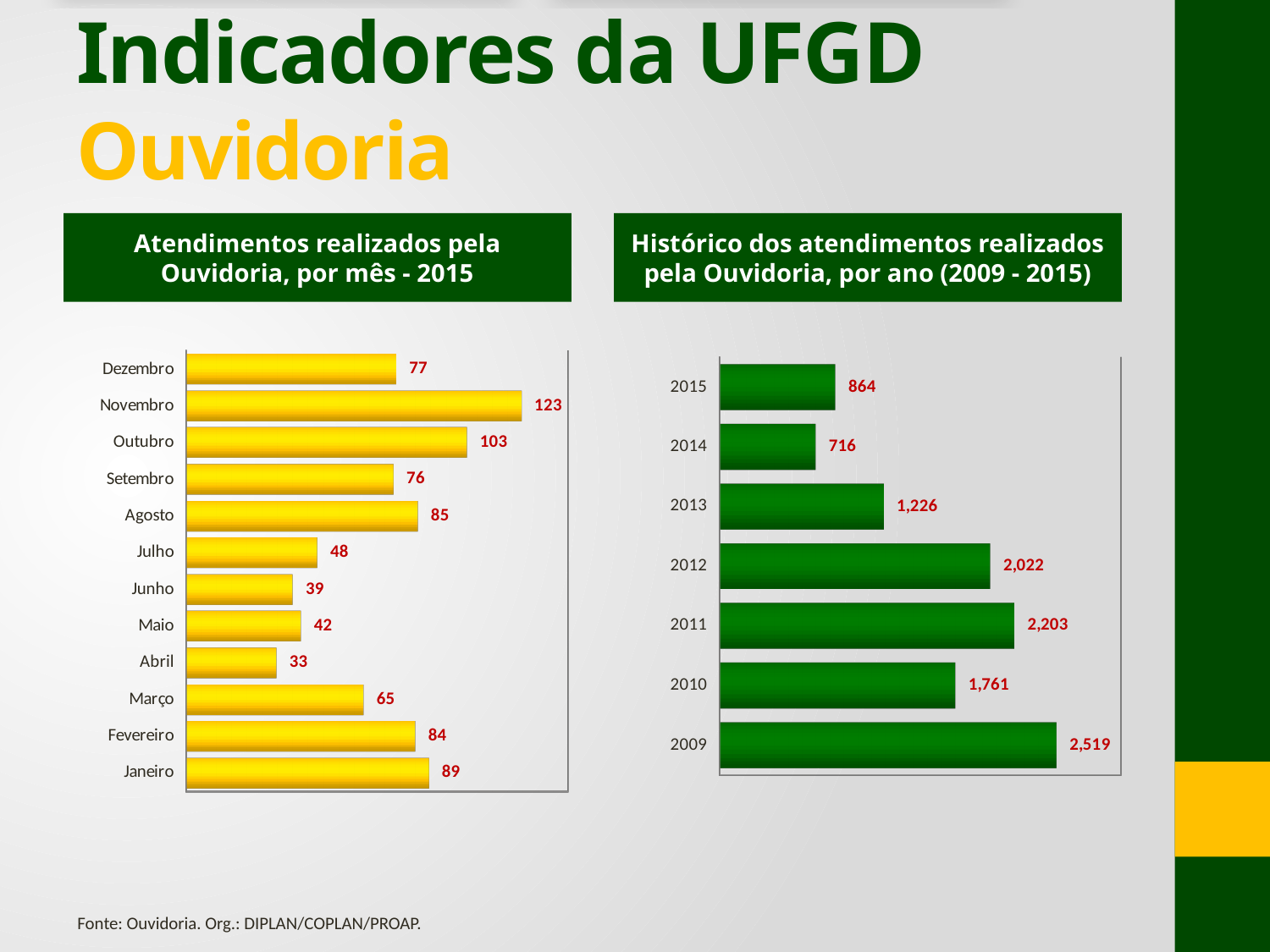
In the left chart (Atendimentos realizados pela Ouvidoria, por mês - 2015), which month has the highest value? Novembro In the left chart (Atendimentos realizados pela Ouvidoria, por mês - 2015), which is larger, Fevereiro or Março? Fevereiro In the right chart (Histórico dos atendimentos realizados pela Ouvidoria, por ano), which year has the lowest value? 2014 What kind of chart is the right chart (Histórico dos atendimentos realizados pela Ouvidoria, por ano)? Bar chart In the left chart (Atendimentos realizados pela Ouvidoria, por mês - 2015), which month has the lowest value? Abril In the left chart (Atendimentos realizados pela Ouvidoria, por mês - 2015), what is the value for Novembro? 123 In the left chart (Atendimentos realizados pela Ouvidoria, por mês - 2015), how many months are shown? 12 In the left chart (Atendimentos realizados pela Ouvidoria, por mês - 2015), what is the difference between Outubro and Setembro? 27 In the right chart (Histórico dos atendimentos realizados pela Ouvidoria, por ano), how many years are shown? 7 In the right chart (Histórico dos atendimentos realizados pela Ouvidoria, por ano), which year has the highest value? 2009 In the right chart (Histórico dos atendimentos realizados pela Ouvidoria, por ano), what is the difference between 2011 and 2012? 181 In the right chart (Histórico dos atendimentos realizados pela Ouvidoria, por ano), what is the value for 2013? 1,226